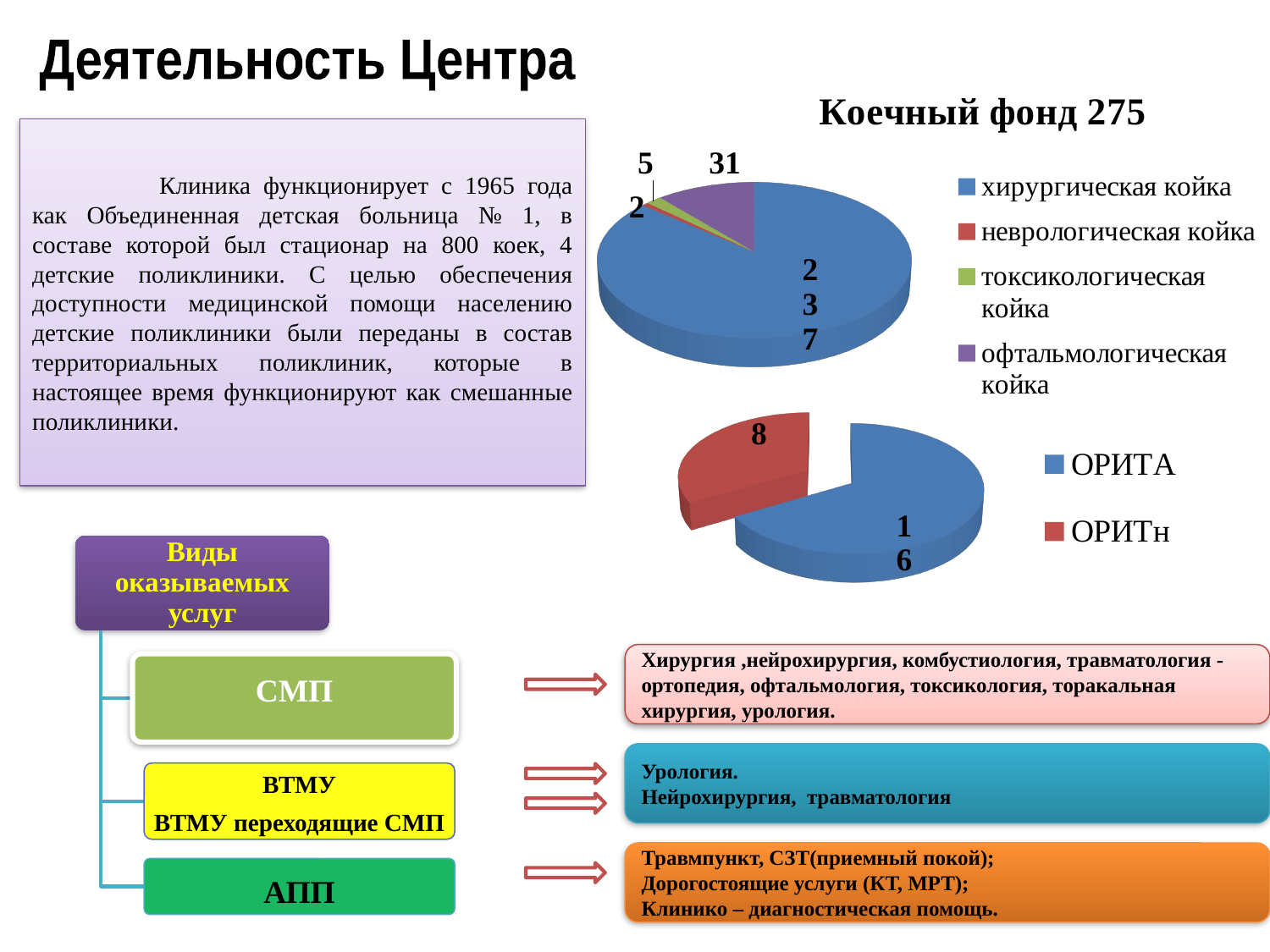
In the pie chart titled "Коечный фонд 275", what is the value for хирургическая койка? 237 In the pie chart titled "Коечный фонд 275", which category has the smallest slice? неврологическая койка In the pie chart titled "Коечный фонд 275", what is the value for токсикологическая койка? 5 In the pie chart titled "Коечный фонд 275", what is the value for офтальмологическая койка? 31 In the lower pie chart on the right, which is larger, ОРИТА or ОРИТн? ОРИТА In the pie chart titled "Коечный фонд 275", what is the difference between the values for офтальмологическая койка and токсикологическая койка? 26 What type of chart is the chart titled "Коечный фонд 275"? pie chart In the lower pie chart on the right (ОРИТА / ОРИТн), what is the value for ОРИТА? 16 In the pie chart titled "Коечный фонд 275", which category has the largest slice? хирургическая койка In the lower pie chart on the right (ОРИТА / ОРИТн), what is the value for ОРИТн? 8 How many categories does the legend of the pie chart titled "Коечный фонд 275" list? 4 In the lower pie chart on the right, what is the difference between the values for ОРИТА and ОРИТн? 8